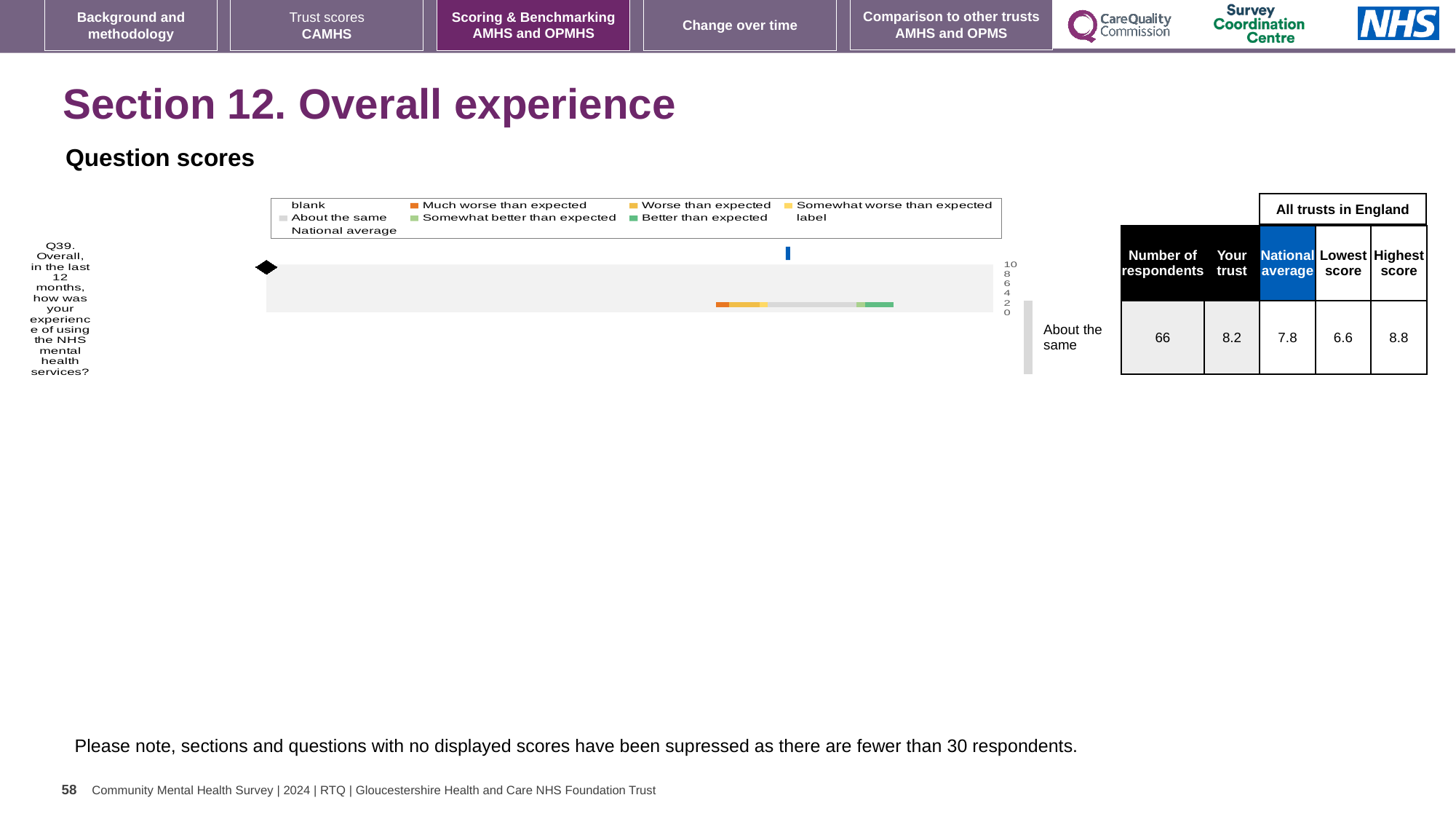
Which benchmarking category is the trust's Q39 score placed in? About the same What kind of chart is shown on the slide for Q39? bar chart Which is higher for Q39: the trust's score or the national average? Your trust How many questions are plotted in the chart? 1 What is the 'Your trust' score for Q39 (Overall, in the last 12 months, how was your experience of using the NHS mental health services?)? 8.2 What is the lowest score among all trusts in England for Q39? 6.6 How many respondents answered Q39? 66 What is the highest score among all trusts in England for Q39? 8.8 What is the national average score for Q39? 7.8 By how much does the trust's score for Q39 exceed the national average? 0.4 What does the blue vertical marker in the chart represent, according to the legend? National average What is the difference between the highest and lowest scores for Q39 across all trusts in England? 2.2